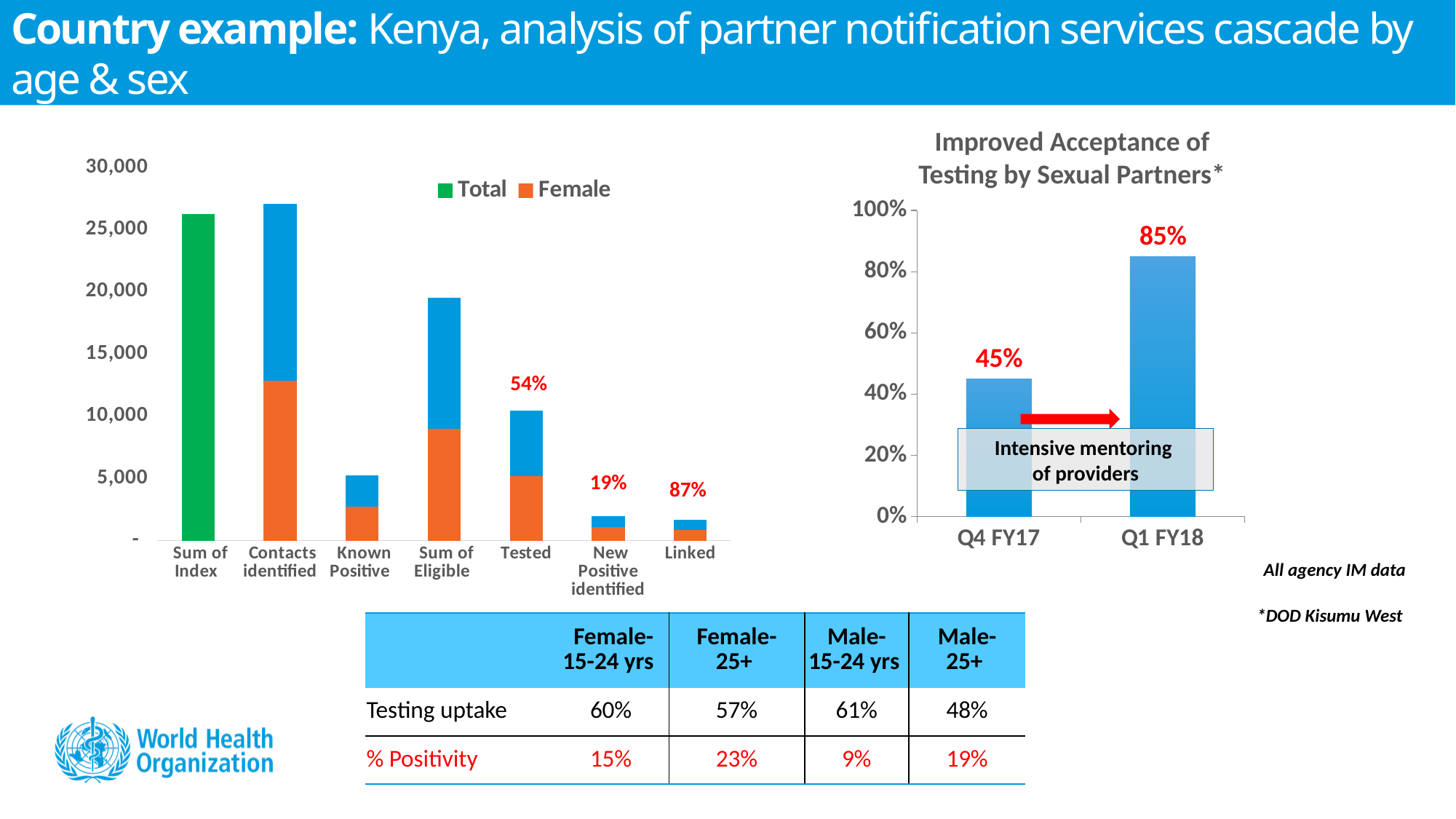
In the chart titled 'Improved Acceptance of Testing by Sexual Partners', what is the value for Q4 FY17? 45% In the chart titled 'Improved Acceptance of Testing by Sexual Partners', do the values rise or fall from Q4 FY17 to Q1 FY18? rise In the chart on the left of the slide, is the total value for 'Sum of Eligible' greater or less than 20,000? less In the chart titled 'Improved Acceptance of Testing by Sexual Partners', how many bars are plotted? 2 In the chart titled 'Improved Acceptance of Testing by Sexual Partners', what is the value for Q1 FY18? 85% In the chart on the left of the slide, how many series does the legend list? 2 In the chart titled 'Improved Acceptance of Testing by Sexual Partners', which quarter has the higher value? Q1 FY18 In the chart on the left of the slide, how many categories are shown on the x axis? 7 In the chart titled 'Improved Acceptance of Testing by Sexual Partners', what is the difference between the Q1 FY18 and Q4 FY17 values? 40% In the chart on the left of the slide, is the total value for 'Contacts identified' greater or less than 25,000? greater What kind of chart is the chart on the left of the slide? bar chart In the chart on the left of the slide, which has the larger total bar, 'Sum of Eligible' or 'Tested'? Sum of Eligible